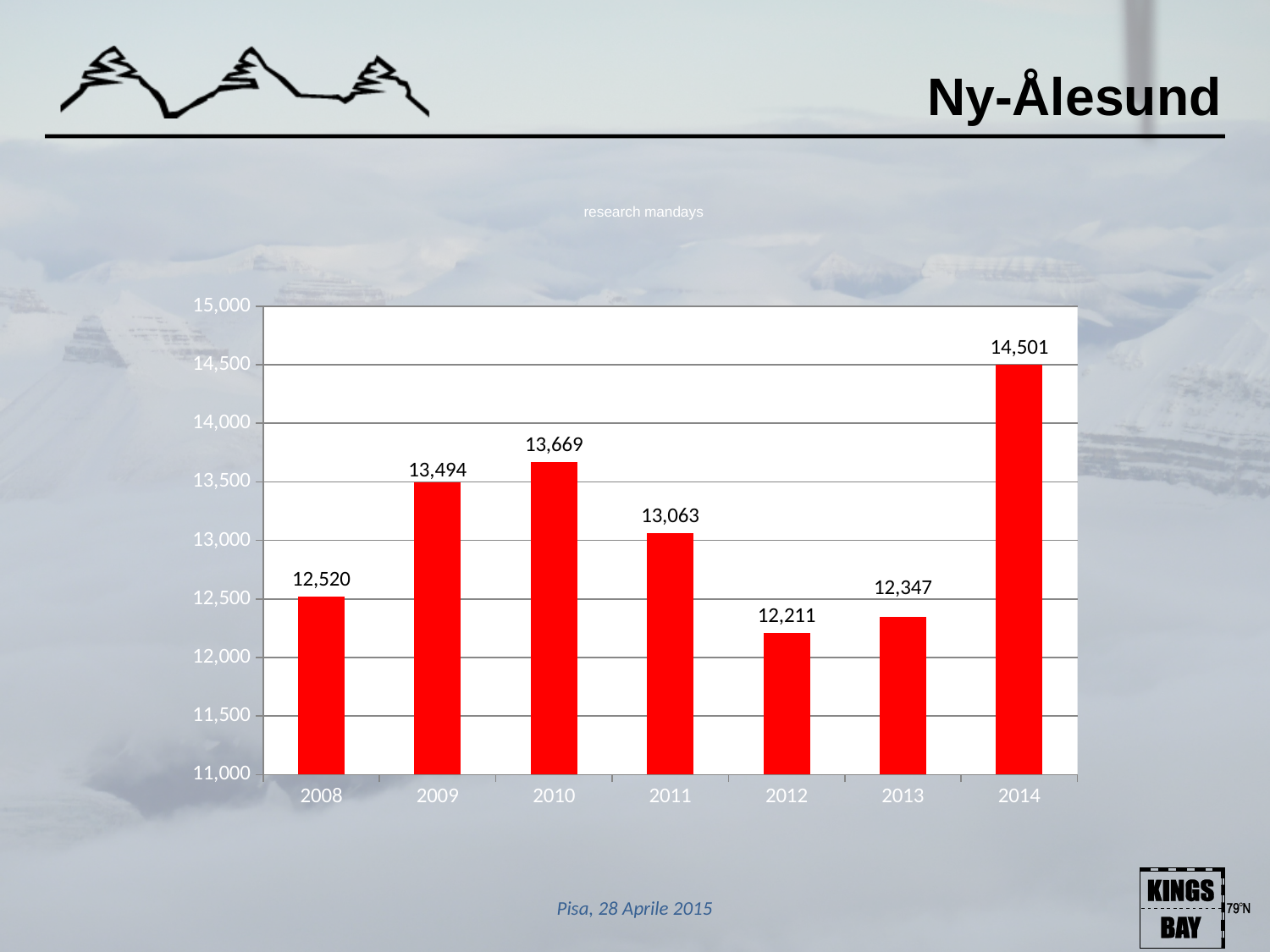
What is the difference between the values for 2010 and 2009? 175 What kind of chart is shown on the slide? bar chart How many years are shown on the x axis? 7 What is the value for 2011? 13,063 Which year has the lowest value? 2012 Which is larger, the value for 2009 or the value for 2011? 2009 What is the value for 2013? 12,347 What is the difference between the values for 2014 and 2012? 2,290 Which year has the highest value? 2014 What is the value for 2008? 12,520 Do the values rise or fall from 2010 to 2012? fall Is the value for 2010 greater or less than 13,500? greater